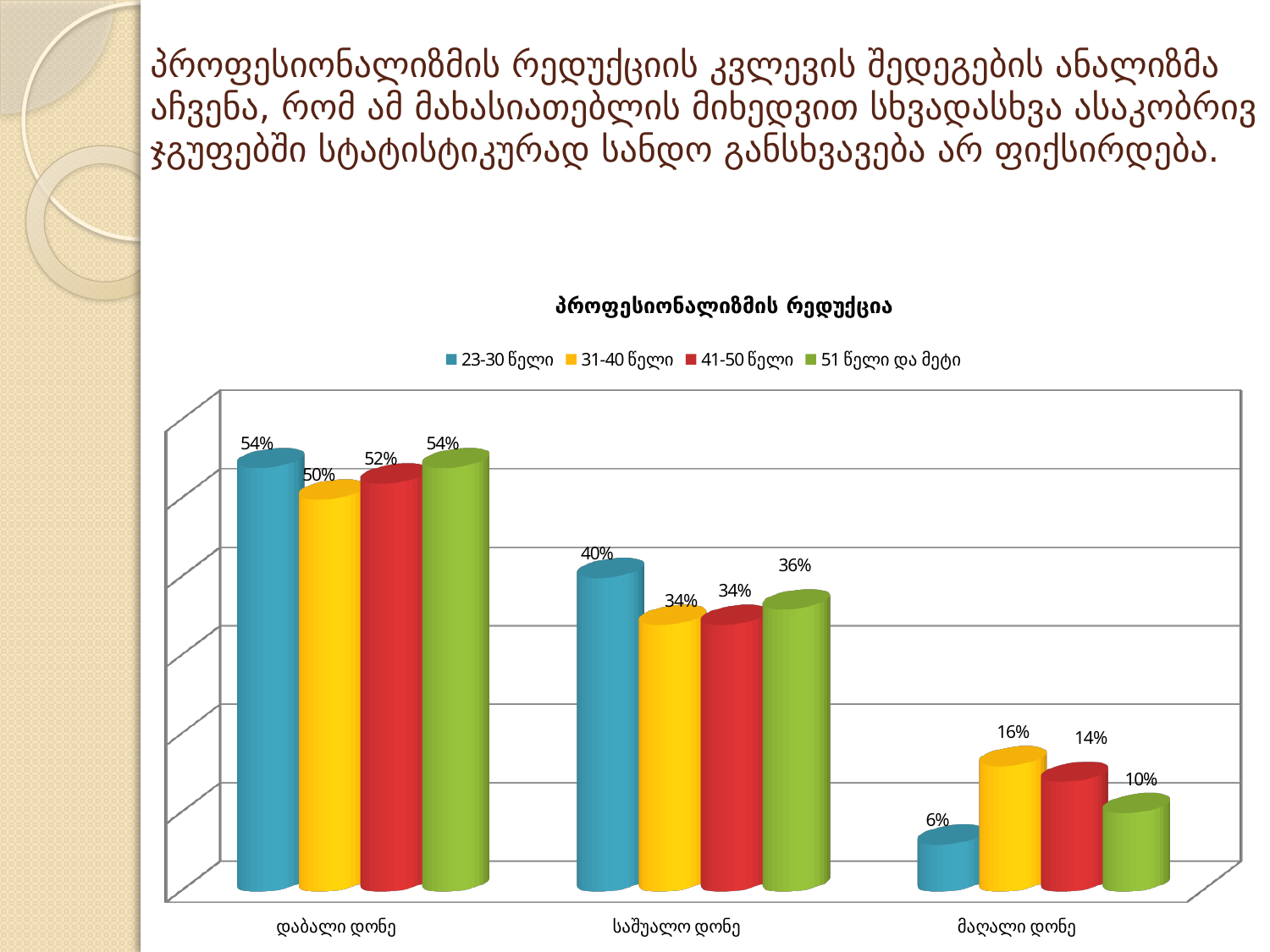
Which series has the lowest value in the მაღალი დონე category? 23-30 წელი What is the value for the 31-40 წელი series in the საშუალო დონე category? 34% What is the difference between the 23-30 წელი value and the 31-40 წელი value in the საშუალო დონე category? 6% What is the value for the 41-50 წელი series in the დაბალი დონე category? 52% What is the value for the 51 წელი და მეტი series in the მაღალი დონე category? 10% How many series does the legend list? 4 What is the value for the 23-30 წელი series in the დაბალი დონე category? 54% Which series has the highest value in the მაღალი დონე category? 31-40 წელი What is the title of the chart? პროფესიონალიზმის რედუქცია What kind of chart is shown on the slide? Bar chart In the მაღალი დონე category, which is larger: the 41-50 წელი value or the 51 წელი და მეტი value? 41-50 წელი How many categories are shown on the x axis? 3